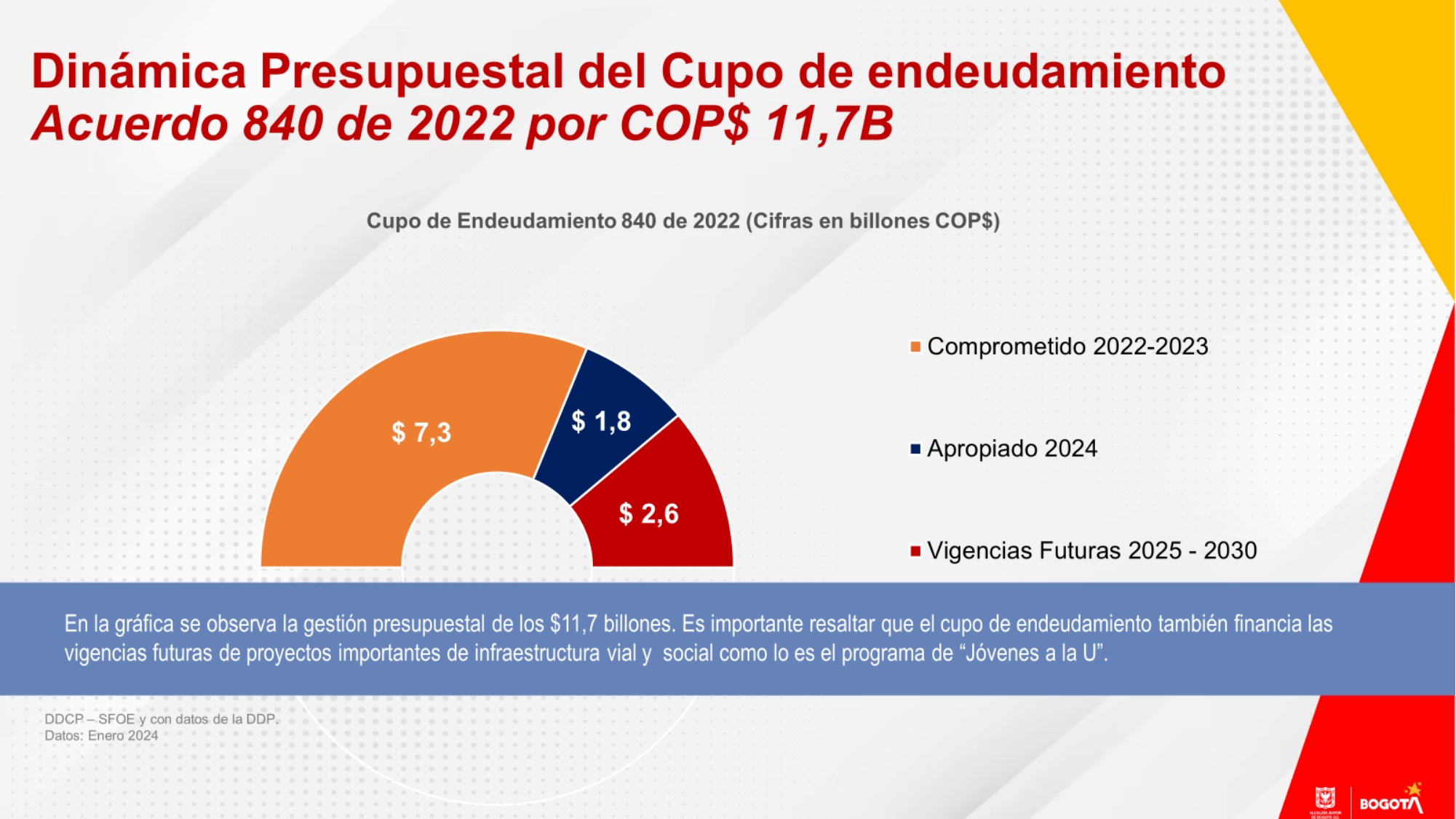
What is the difference between the values for Comprometido 2022-2023 and Apropiado 2024? 5,5 What is the value for Apropiado 2024 in the chart? $ 1,8 Which category has the largest value in the chart? Comprometido 2022-2023 What is the value for Vigencias Futuras 2025 - 2030 in the chart? $ 2,6 Which is larger, the value for Vigencias Futuras 2025 - 2030 or the value for Apropiado 2024? Vigencias Futuras 2025 - 2030 What is the value for Comprometido 2022-2023 in the chart? $ 7,3 What is the difference between the values for Vigencias Futuras 2025 - 2030 and Apropiado 2024? 0,8 What is the title of the chart? Cupo de Endeudamiento 840 de 2022 (Cifras en billones COP$) How many categories does the chart show? 3 What is the total of the three values shown in the chart? 11,7 What kind of chart is shown on the slide? Doughnut chart Which category has the smallest value in the chart? Apropiado 2024